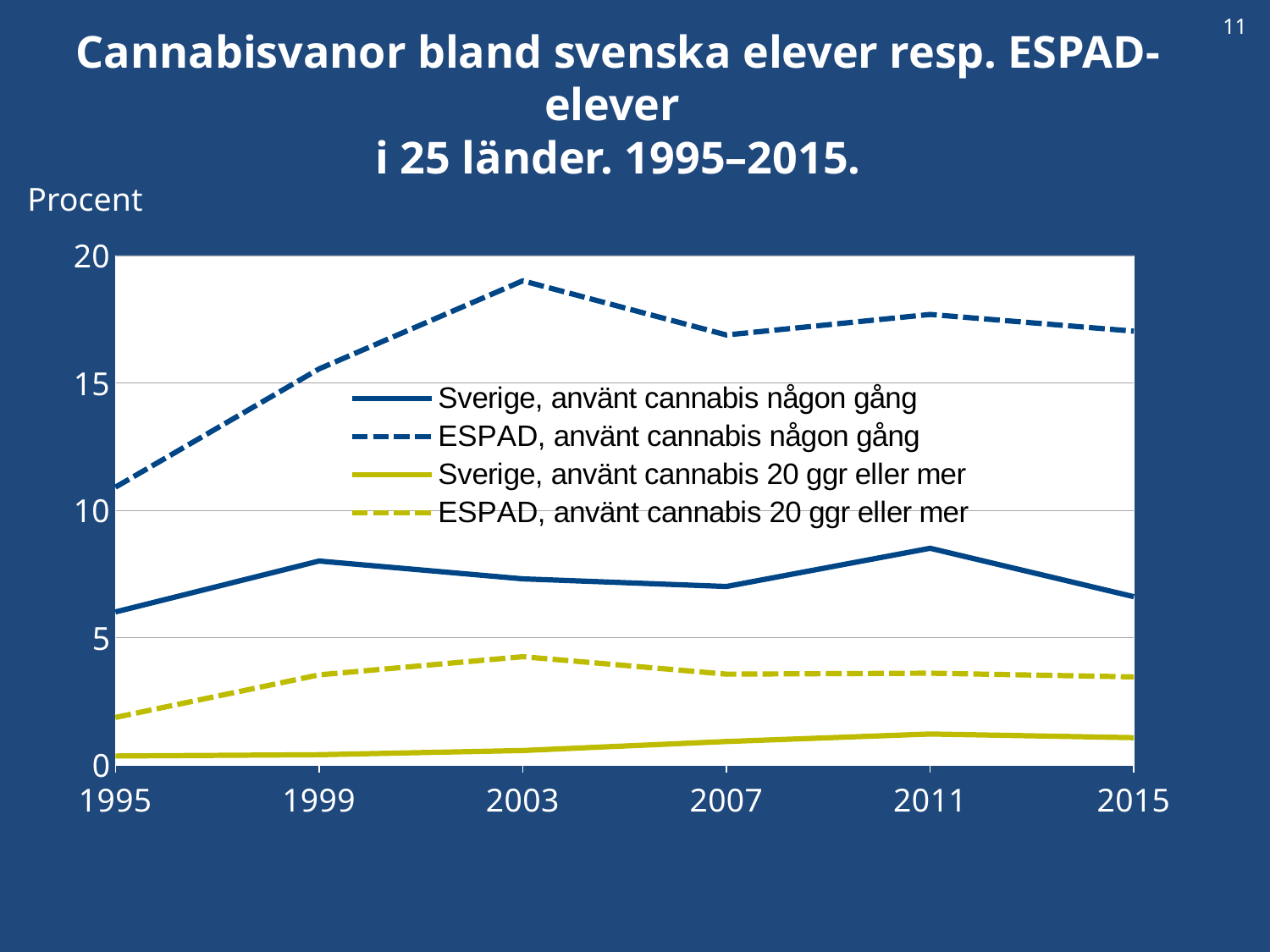
In which year does the series 'ESPAD, använt cannabis någon gång' reach its highest value? 2003 Is the value for 'Sverige, använt cannabis någon gång' in 1999 greater or less than 10? less What unit is given for the y axis, as labelled above the chart? Procent How many years are marked on the x axis? 6 Is the value for 'ESPAD, använt cannabis 20 ggr eller mer' in 2003 greater or less than 5? less What kind of chart is shown on the slide? line chart In 2015, which is larger: 'ESPAD, använt cannabis någon gång' or 'Sverige, använt cannabis någon gång'? ESPAD, använt cannabis någon gång Does the series 'ESPAD, använt cannabis någon gång' rise or fall between 1995 and 2003? rise Is the value for 'ESPAD, använt cannabis någon gång' in 2003 greater or less than 15? greater How many series does the legend list? 4 In which year does the series 'ESPAD, använt cannabis 20 ggr eller mer' peak? 2003 In which year is the series 'ESPAD, använt cannabis någon gång' at its lowest? 1995